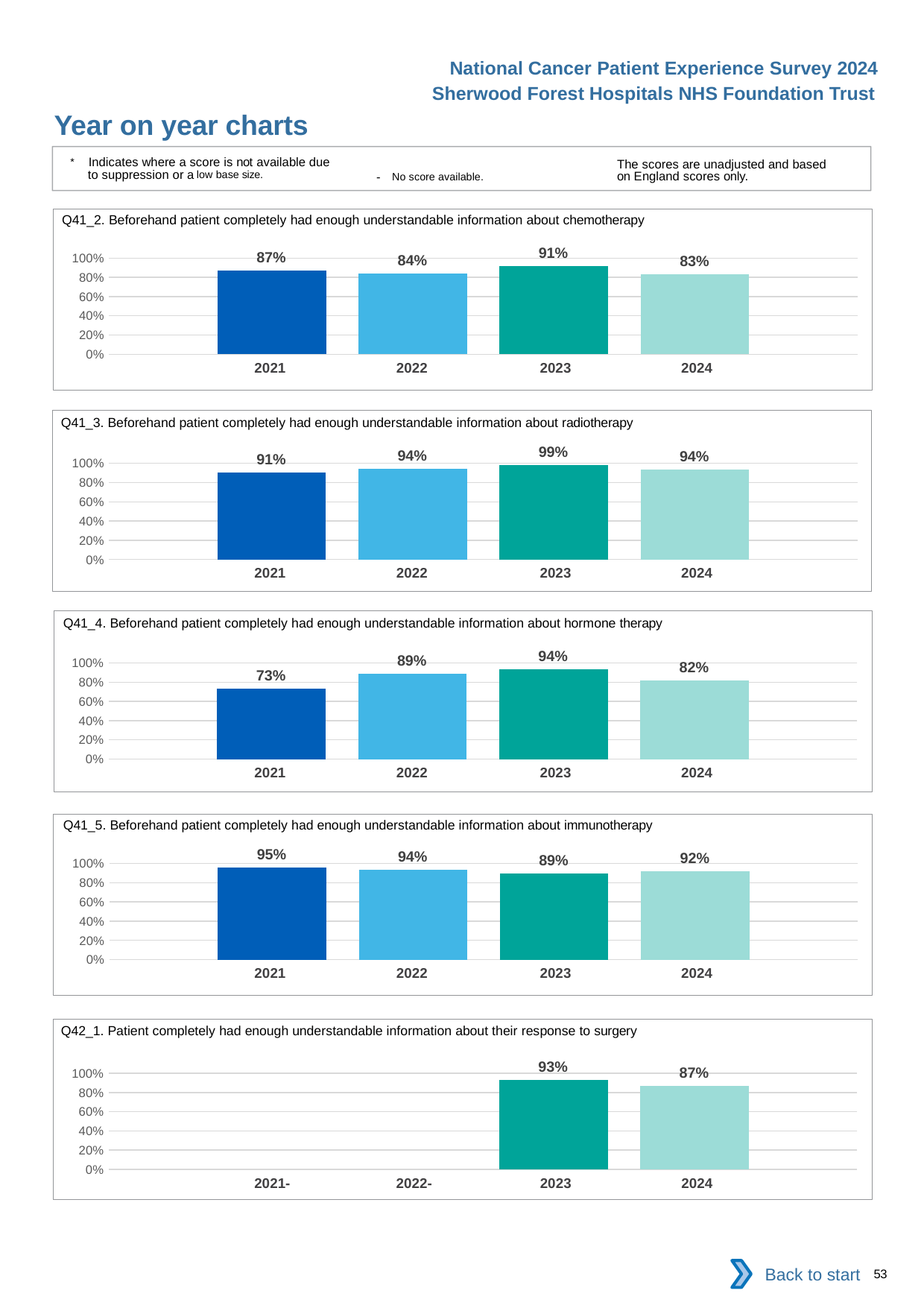
In the Q41_2 chemotherapy chart, what is the value for 2023? 91% In the Q41_5 immunotherapy chart, do the values rise or fall from 2021 to 2023? Fall In the Q41_3 radiotherapy chart, which year has the highest value? 2023 In the Q42_1 surgery chart, how many years have a bar plotted? 2 In the Q41_4 hormone therapy chart, which year has the lowest value? 2021 In the Q41_4 hormone therapy chart, what is the difference between the 2022 and 2021 values? 16% How many charts are shown on the slide? 5 In the Q41_3 radiotherapy chart, what is the difference between the 2023 and 2021 values? 8% In the Q41_5 immunotherapy chart, which is larger, the value for 2021 or the value for 2023? 2021 In the Q41_2 chemotherapy chart, how many years are shown on the x axis? 4 What type of chart is the Q41_2 chemotherapy chart? Bar chart In the Q42_1 surgery chart, what is the value for 2024? 87%